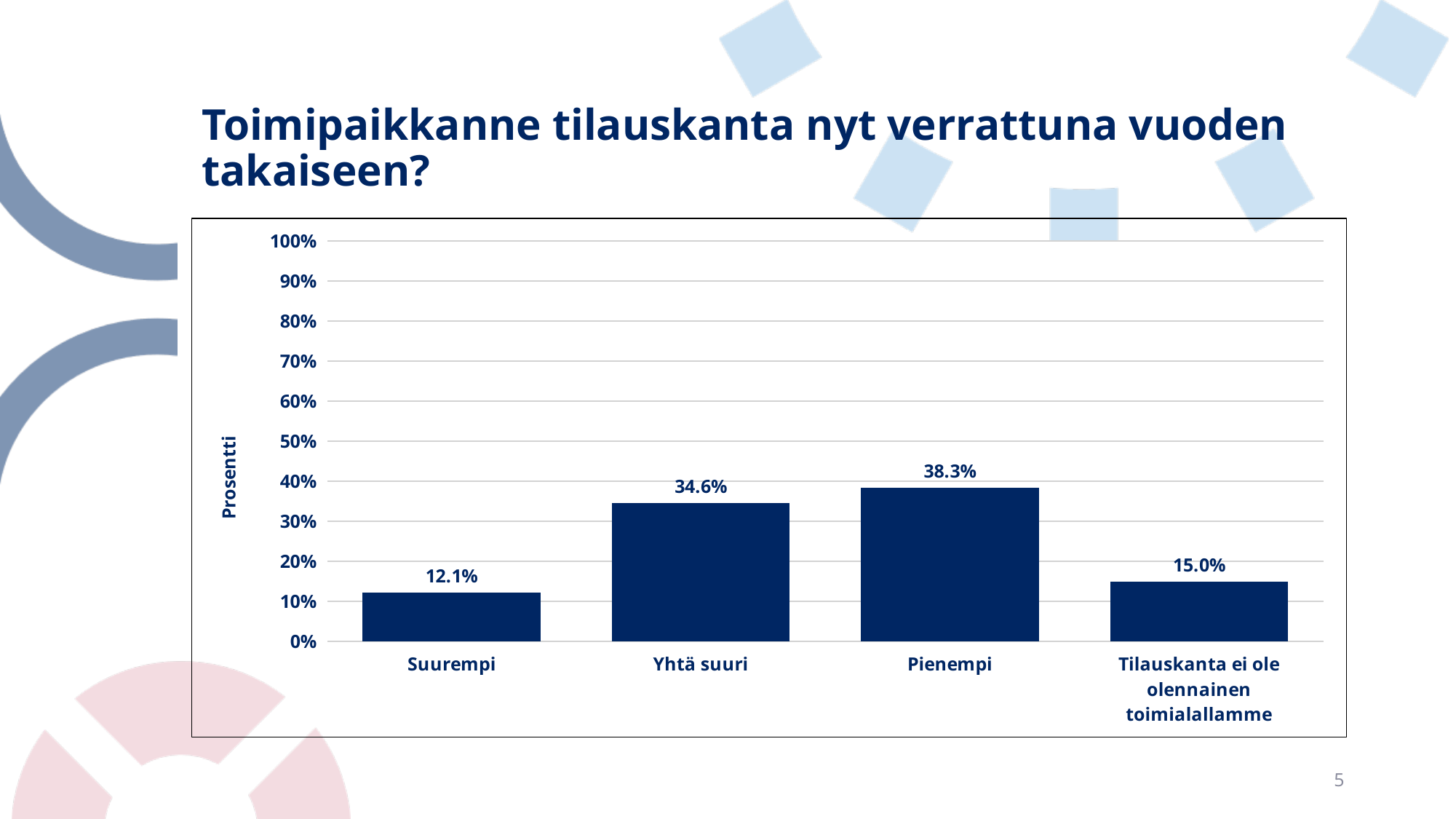
What is the label of the vertical axis? Prosentti What is the value for 'Tilauskanta ei ole olennainen toimialallamme'? 15.0% Which is larger, the value for Yhtä suuri or the value for Suurempi? Yhtä suuri What is the difference between the values for Pienempi and Yhtä suuri? 3.7% What is the value for Suurempi? 12.1% What is the value for Pienempi? 38.3% How many categories are shown on the x axis? 4 What kind of chart is shown on the slide? Bar chart Which category has the highest value? Pienempi What is the value for Yhtä suuri? 34.6% What is the difference between the values for 'Tilauskanta ei ole olennainen toimialallamme' and Suurempi? 2.9% Which category has the lowest value? Suurempi